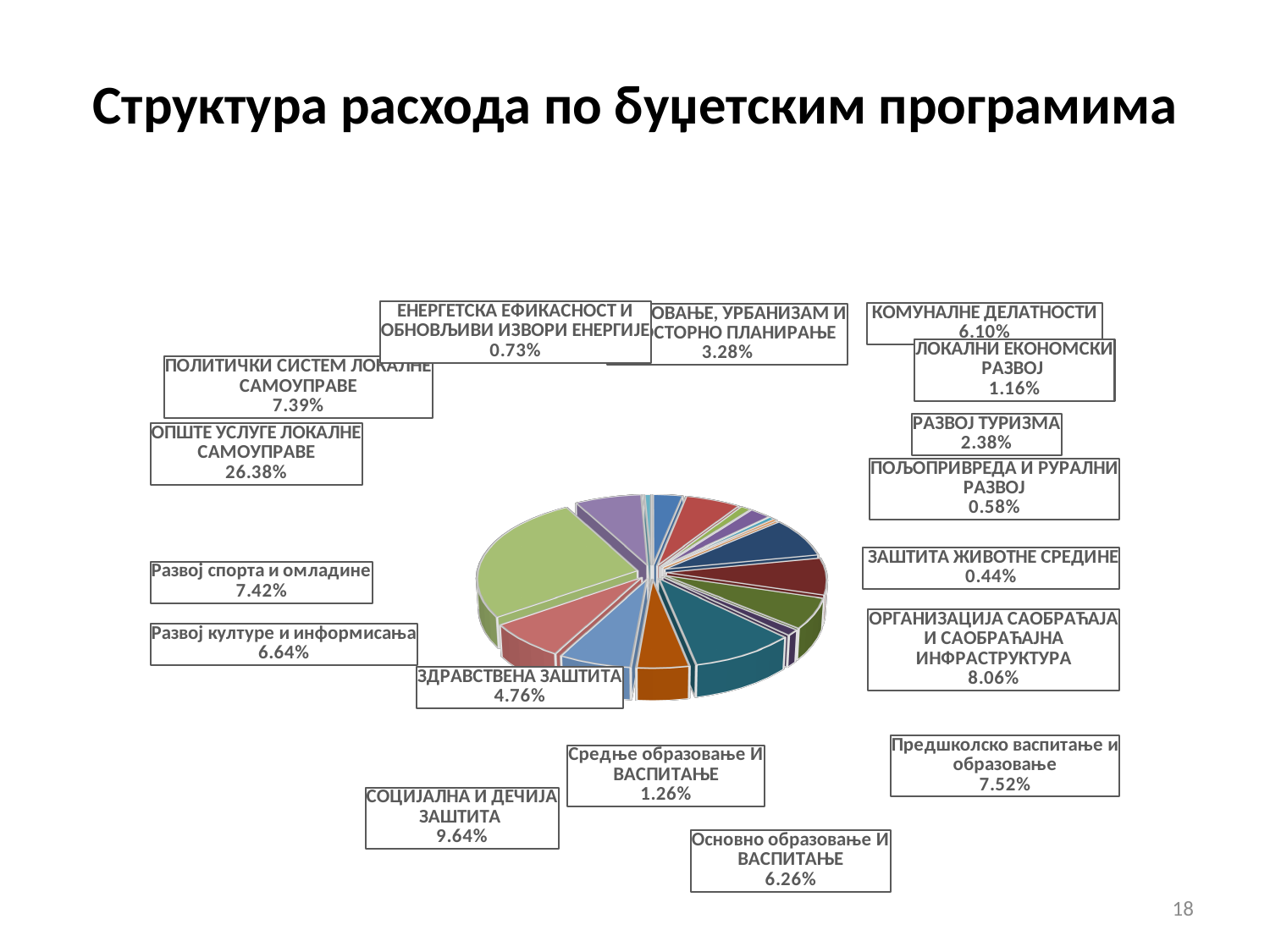
What percentage is shown for СОЦИЈАЛНА И ДЕЧИЈА ЗАШТИТА? 9.64% What percentage is shown for РАЗВОЈ ТУРИЗМА? 2.38% What share does ОПШТЕ УСЛУГЕ ЛОКАЛНЕ САМОУПРАВЕ have in the pie chart? 26.38% What is the difference in percentage points between СОЦИЈАЛНА И ДЕЧИЈА ЗАШТИТА and ОРГАНИЗАЦИЈА САОБРАЋАЈА И САОБРАЋАЈНА ИНФРАСТРУКТУРА? 1.58 What is the title of the chart on the slide? Структура расхода по буџетским програмима What is the difference in percentage points between ОПШТЕ УСЛУГЕ ЛОКАЛНЕ САМОУПРАВЕ and СОЦИЈАЛНА И ДЕЧИЈА ЗАШТИТА? 16.74 What percentage is shown for ОРГАНИЗАЦИЈА САОБРАЋАЈА И САОБРАЋАЈНА ИНФРАСТРУКТУРА? 8.06% Which program has the largest share of the pie chart? ОПШТЕ УСЛУГЕ ЛОКАЛНЕ САМОУПРАВЕ Which has a larger share: Предшколско васпитање и образовање or Основно образовање И ВАСПИТАЊЕ? Предшколско васпитање и образовање Which program has the smallest share of the pie chart? ЗАШТИТА ЖИВОТНЕ СРЕДИНЕ How many program categories are labelled in the pie chart? 17 What type of chart is shown on the slide? Pie chart